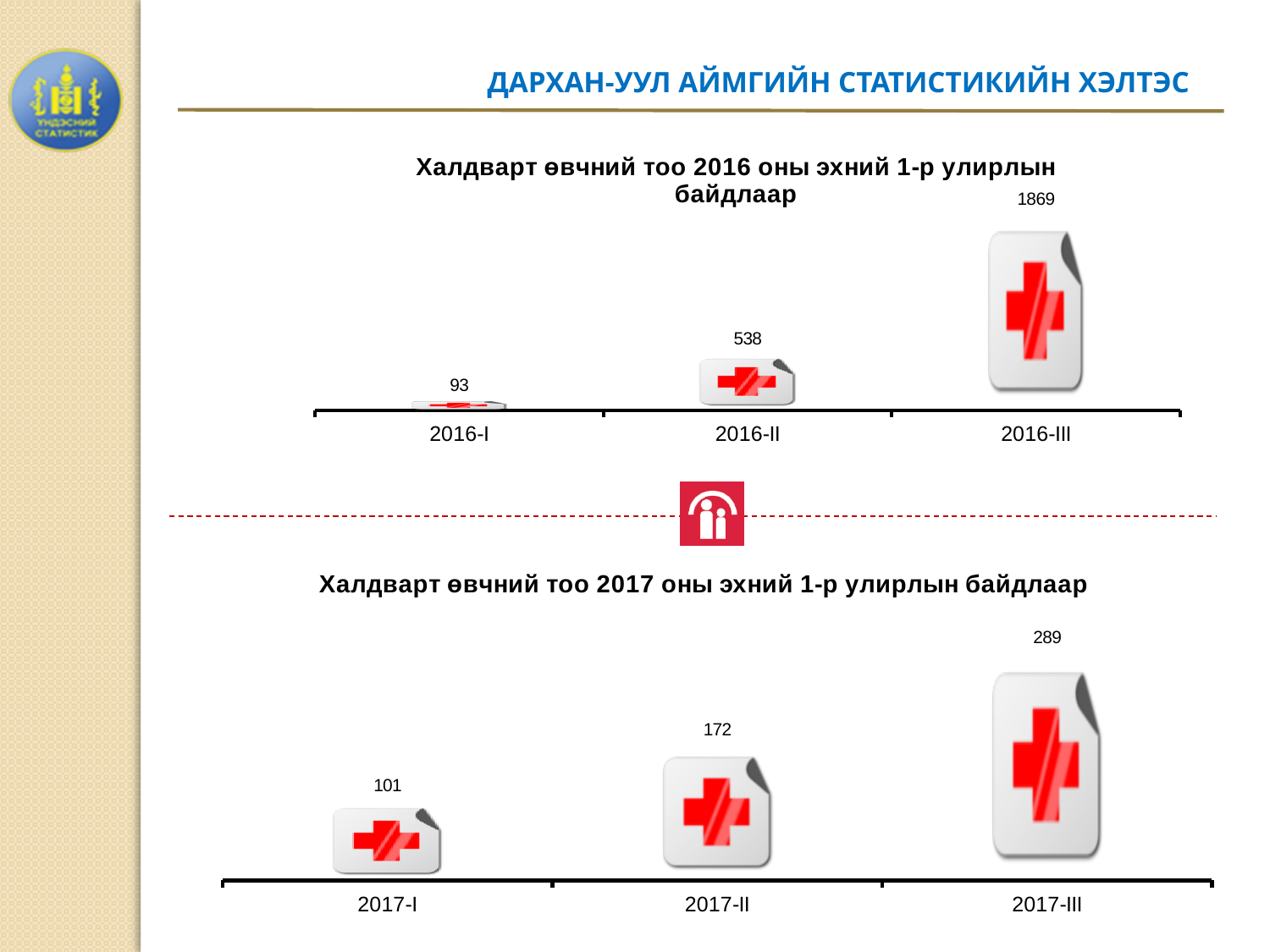
In the bottom chart (2017), what is the difference between the values for 2017-III and 2017-II? 117 In the bottom chart (2017), which is larger, the value for 2017-I or 2017-II? 2017-II In the top chart (2016), what is the value for 2016-III? 1869 In the top chart (2016), which category has the highest value? 2016-III How many categories are shown in the top chart (2016)? 3 In the top chart (2016), what is the difference between the values for 2016-II and 2016-I? 445 In the bottom chart (2017), what is the value for 2017-II? 172 In the bottom chart (2017), which category has the lowest value? 2017-I What kind of chart is the bottom chart (2017)? Bar chart In the top chart (2016), do the values rise or fall from 2016-I to 2016-III? Rise In the top chart (2016), what is the value for 2016-I? 93 In the bottom chart (2017), what is the value for 2017-III? 289